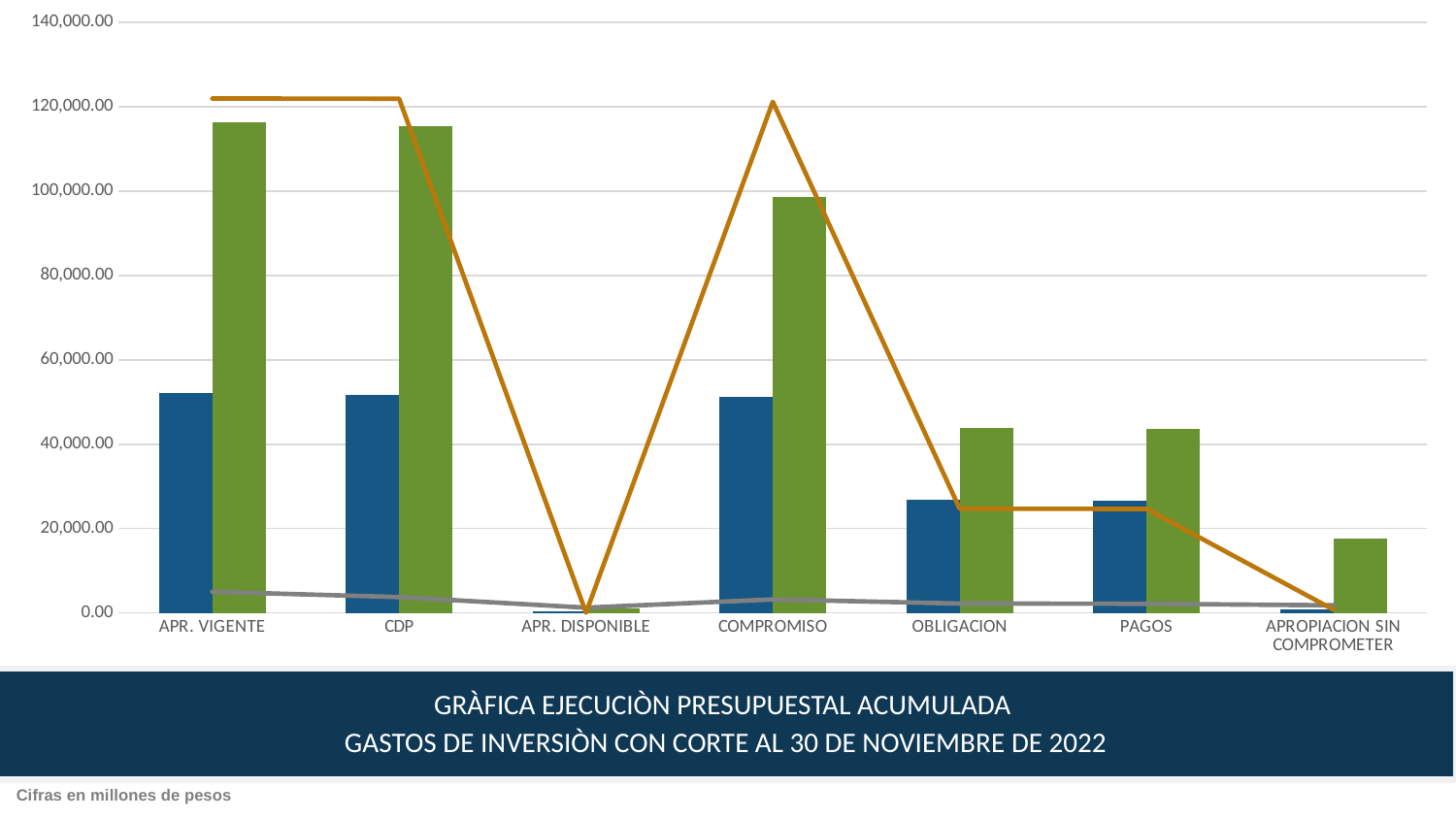
Which blue bar is taller, COMPROMISO or PAGOS? COMPROMISO Does the orange line rise or fall from OBLIGACION to APROPIACION SIN COMPROMETER? fall Is the value of the orange line at APR. DISPONIBLE greater or less than 20,000.00? less How many categories are shown on the x axis of the chart? 7 Is the value of the green bar for APR. VIGENTE greater or less than 100,000.00? greater Which green bar is taller, COMPROMISO or OBLIGACION? COMPROMISO Is the value of the blue bar for APR. VIGENTE greater or less than 40,000.00? greater What kind of chart is shown on the slide? A combined bar and line chart Which category has the lowest green bar? APR. DISPONIBLE What is the highest value shown on the vertical axis of the chart? 140,000.00